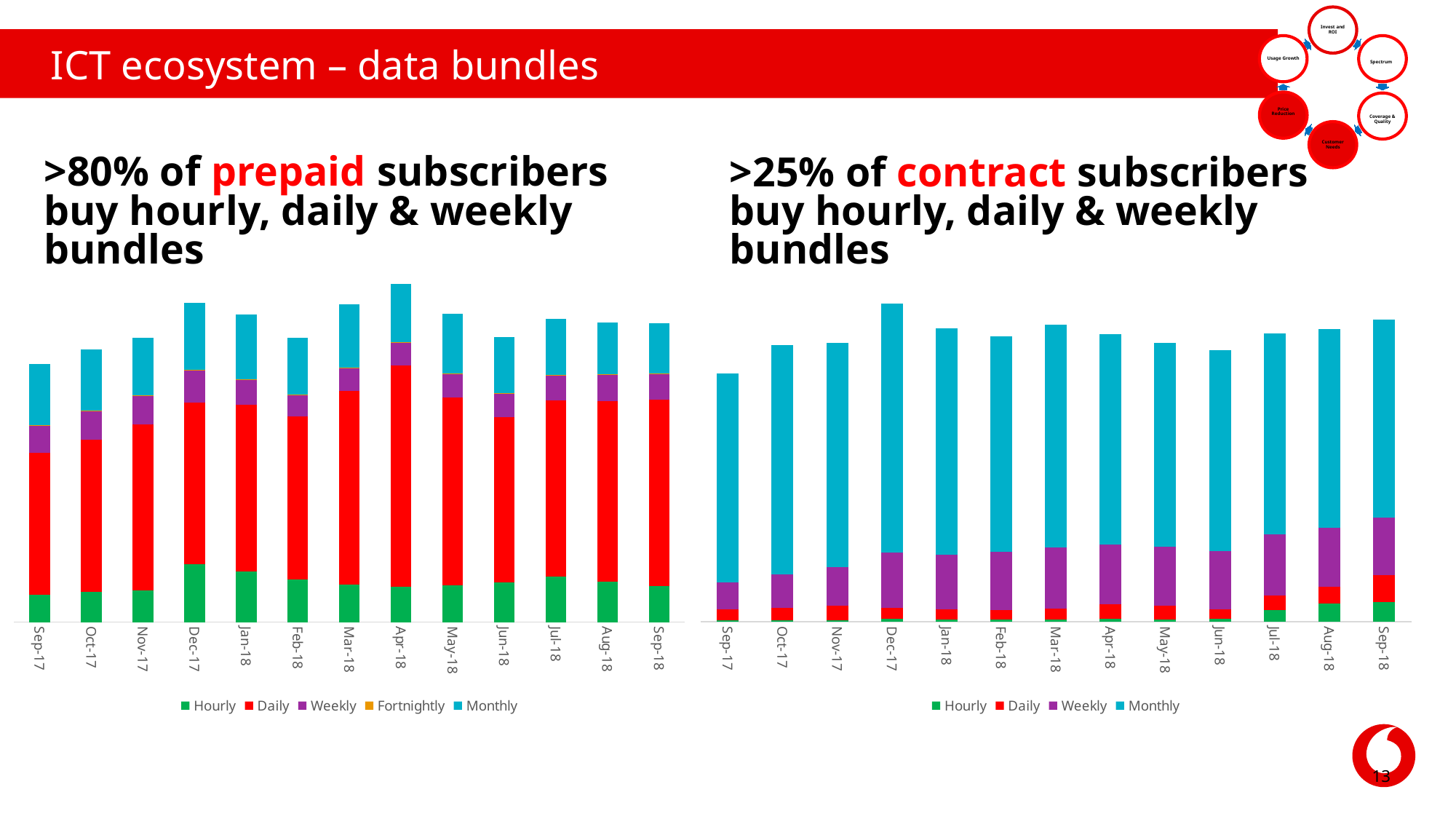
In the right chart (contract subscribers), which month has the tallest stacked bar? Dec-17 Which series appears in the legend of the left chart (prepaid subscribers) but not in the legend of the right chart (contract subscribers)? Fortnightly In the left chart (prepaid subscribers), which month has the tallest stacked bar? Apr-18 In the right chart (contract subscribers), which series makes up the largest part of each bar? Monthly What kind of chart is the left chart (prepaid subscribers)? Stacked bar chart How many months are shown on the x axis of the left chart (prepaid subscribers)? 13 In the left chart (prepaid subscribers), is the total bar for Dec-17 or Sep-17 larger? Dec-17 How many series does the legend of the right chart (contract subscribers) list? 4 In the right chart (contract subscribers), which month has the shortest stacked bar? Sep-17 How many series does the legend of the left chart (prepaid subscribers) list? 5 How many months are shown on the x axis of the right chart (contract subscribers)? 13 In the left chart (prepaid subscribers), which month has the shortest stacked bar? Sep-17